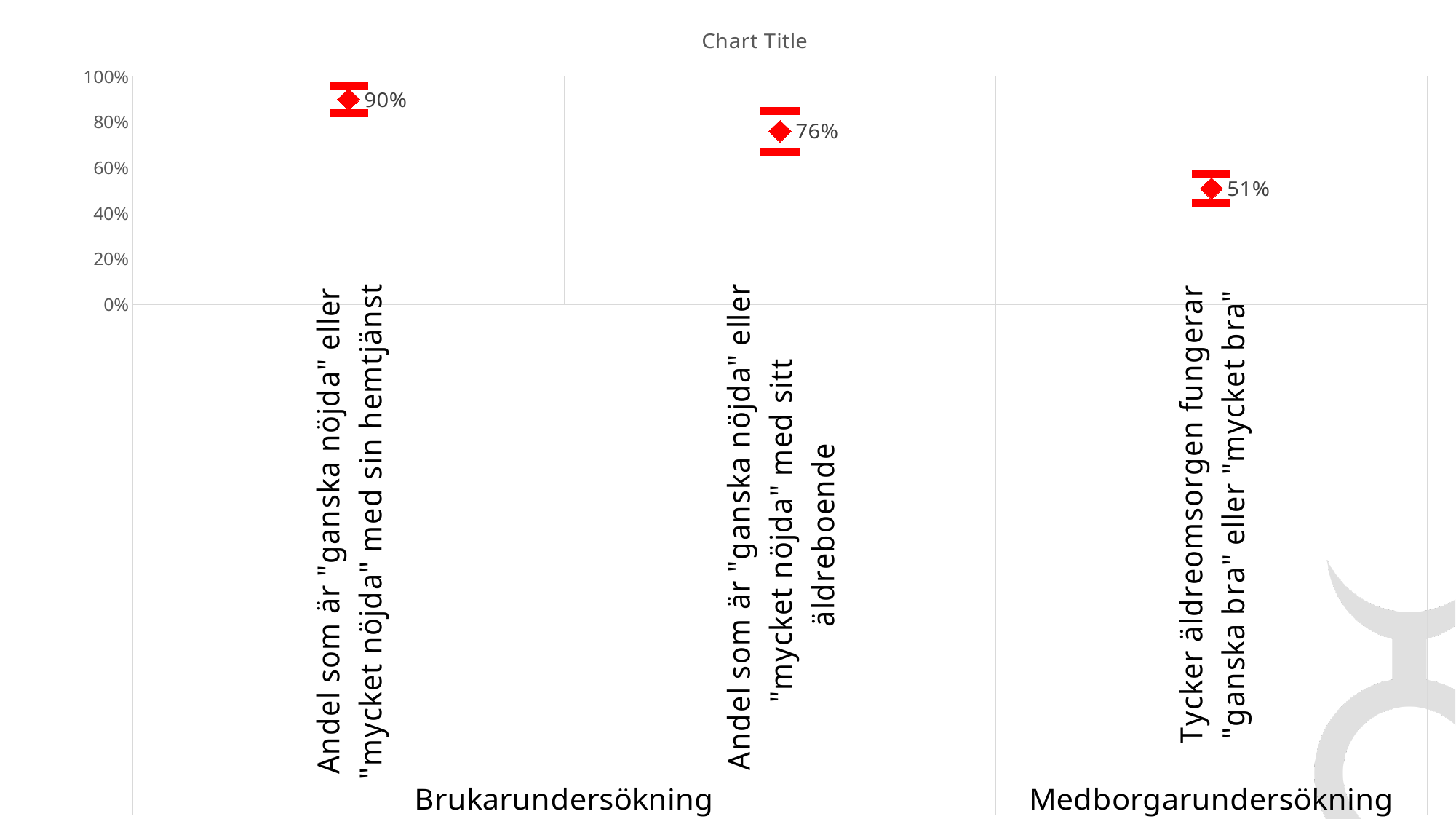
What is the title shown above the chart? Chart Title Which category has the lowest value? Tycker äldreomsorgen fungerar "ganska bra" eller "mycket bra" What is the value for "Andel som är "ganska nöjda" eller "mycket nöjda" med sin hemtjänst"? 90% Which category has the highest value? Andel som är "ganska nöjda" eller "mycket nöjda" med sin hemtjänst What is the difference between the value for hemtjänst (90%) and the value for äldreboende (76%)? 14% What is the value for "Tycker äldreomsorgen fungerar "ganska bra" eller "mycket bra""? 51% Which is larger: the value for hemtjänst or the value for äldreboende? hemtjänst What is the value for "Andel som är "ganska nöjda" eller "mycket nöjda" med sitt äldreboende"? 76% Is the value for "Tycker äldreomsorgen fungerar "ganska bra" eller "mycket bra"" greater or less than 60%? less How many data points are plotted on the chart? 3 Do the values rise or fall from left to right along the x axis? fall What is the difference between the value for äldreboende (76%) and the value for "Tycker äldreomsorgen fungerar "ganska bra" eller "mycket bra"" (51%)? 25%